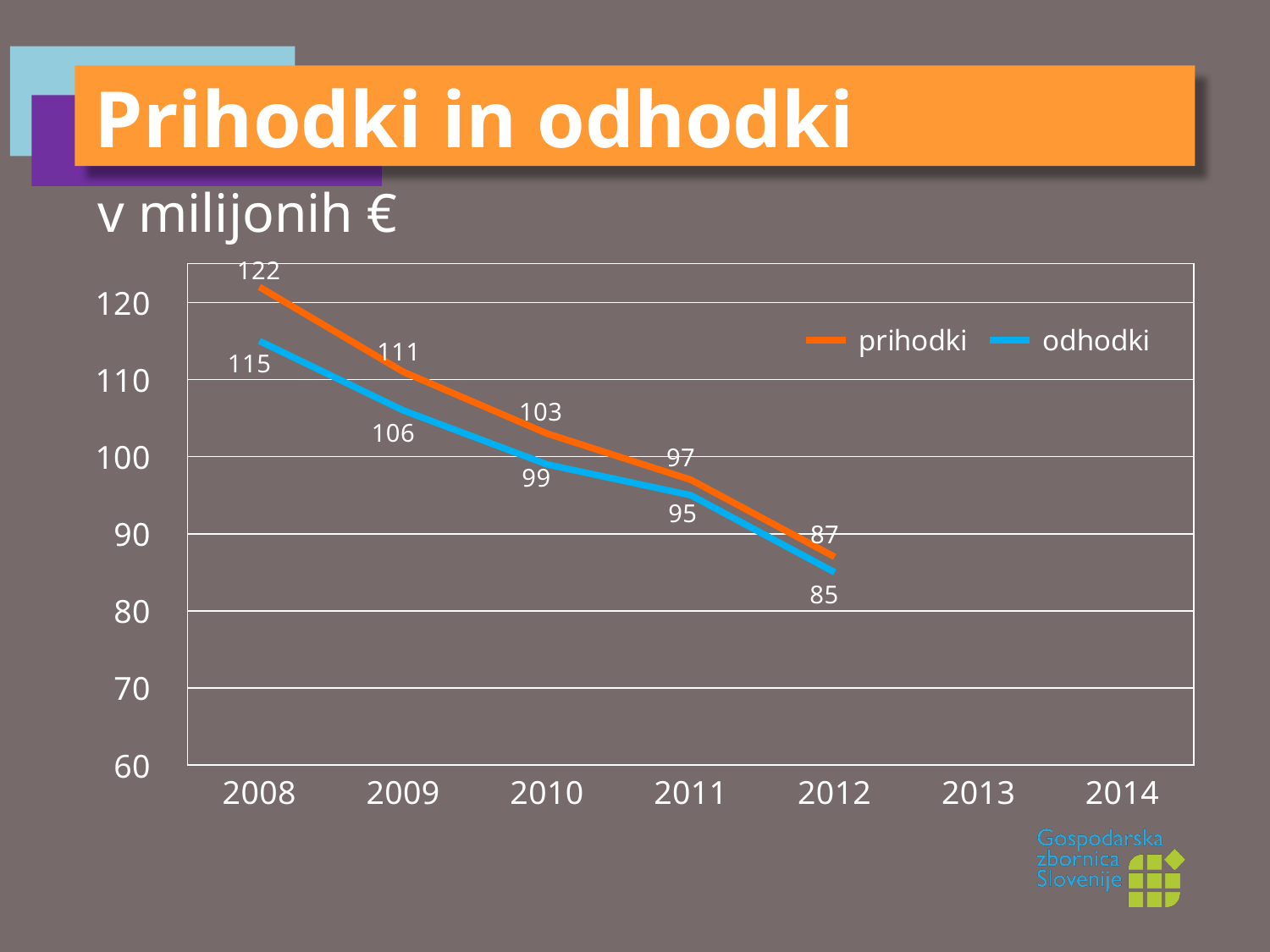
Is the value of odhodki in 2008 greater or less than 110? greater What kind of chart is shown on the slide? line chart What is the value of prihodki in 2012? 87 What is the value of odhodki in 2010? 99 Which is larger in 2011, prihodki or odhodki? prihodki What unit is stated below the chart title? v milijonih € In which year is prihodki highest? 2008 In which year is odhodki lowest? 2012 What is the value of prihodki in 2008? 122 What is the difference between prihodki and odhodki in 2009? 5 How many series does the legend list? 2 Do the prihodki values rise or fall from 2008 to 2012? fall